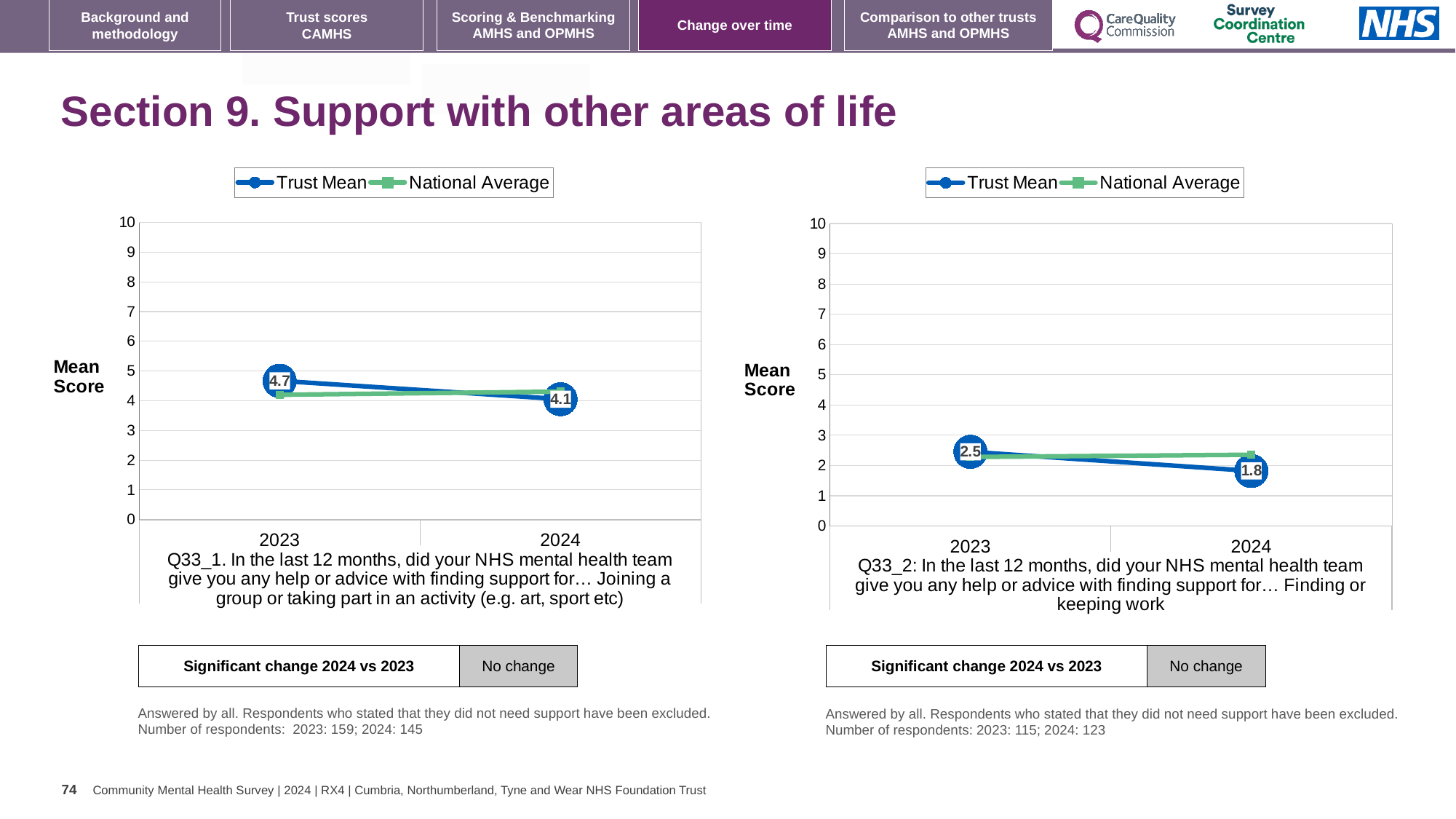
On the left chart (Q33_1), what is the Trust Mean score for 2024? 4.1 On the right chart (Q33_2), what is the difference between the Trust Mean in 2023 and 2024? 0.7 What kind of chart is the left chart (Q33_1)? line chart On the right chart (Q33_2), is the National Average for 2024 greater or less than 2? greater On the left chart (Q33_1), which is larger in 2023: the Trust Mean or the National Average? Trust Mean On the left chart (Q33_1), by how much did the Trust Mean change from 2023 to 2024? 0.6 On the right chart (Q33_2), does the Trust Mean rise or fall from 2023 to 2024? fall On the left chart (Q33_1), does the Trust Mean rise or fall from 2023 to 2024? fall On the left chart (Q33_1), what is the Trust Mean score for 2023? 4.7 On the right chart (Q33_2), what is the Trust Mean score for 2024? 1.8 How many series does the legend of the right chart (Q33_2) list? 2 On the right chart (Q33_2), what is the Trust Mean score for 2023? 2.5